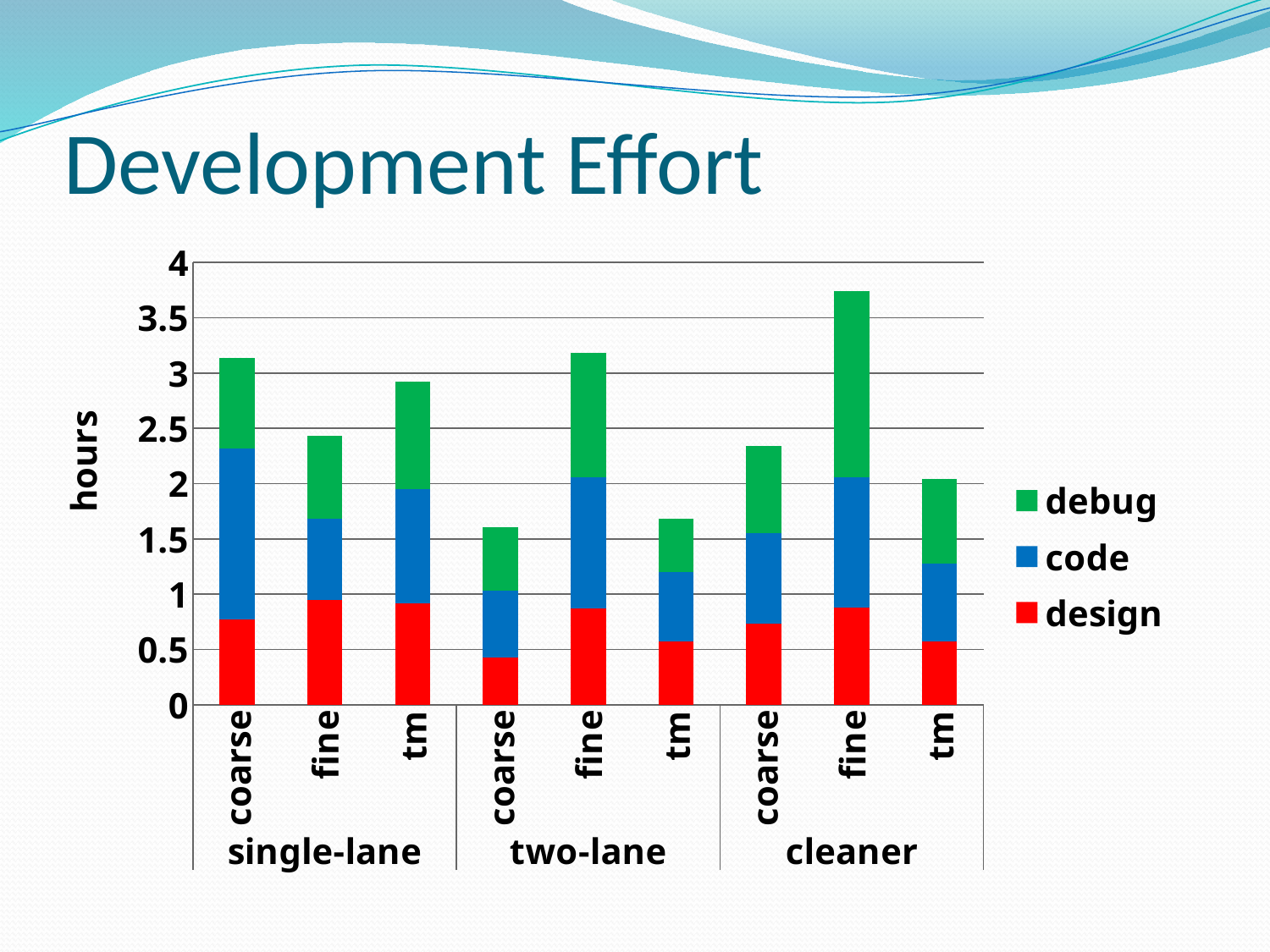
How many bars are plotted in the chart? 9 Is the total for the two-lane coarse bar greater or less than 2 hours? less Which has a larger total: cleaner fine or two-lane fine? cleaner fine Is the total for the cleaner fine bar greater or less than 3.5 hours? greater Which has a larger total: single-lane coarse or single-lane fine? single-lane coarse What is the label on the vertical axis? hours How many series does the legend list? 3 Is the total for the single-lane fine bar greater or less than 3 hours? less Which series is shown in red? design What kind of chart is shown on the slide? stacked bar chart Which bar has the highest total hours? cleaner fine